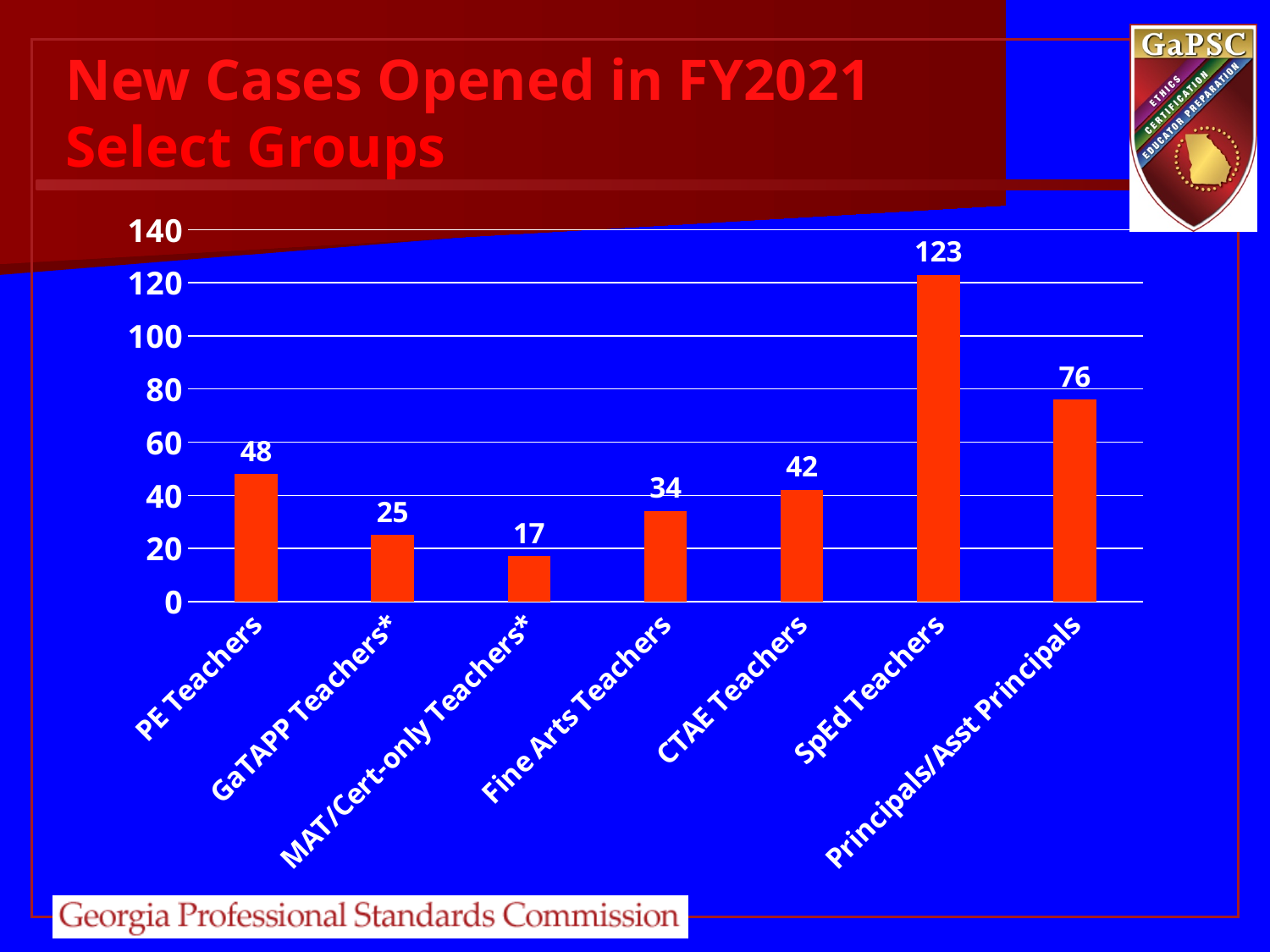
What is the value shown for Principals/Asst Principals? 76 What is the value shown for GaTAPP Teachers*? 25 How many groups are shown on the chart? 7 Which group has the highest number of new cases opened? SpEd Teachers Which group has the lowest number of new cases opened? MAT/Cert-only Teachers* What is the difference between the values for SpEd Teachers and Principals/Asst Principals? 47 How many new cases were opened for SpEd Teachers? 123 What kind of chart is shown on the slide? bar chart Is the value for Principals/Asst Principals greater or less than 60? greater Which has a larger value, Fine Arts Teachers or CTAE Teachers? CTAE Teachers What is the difference between the values for PE Teachers and CTAE Teachers? 6 What is the title of the slide containing the chart? New Cases Opened in FY2021 Select Groups